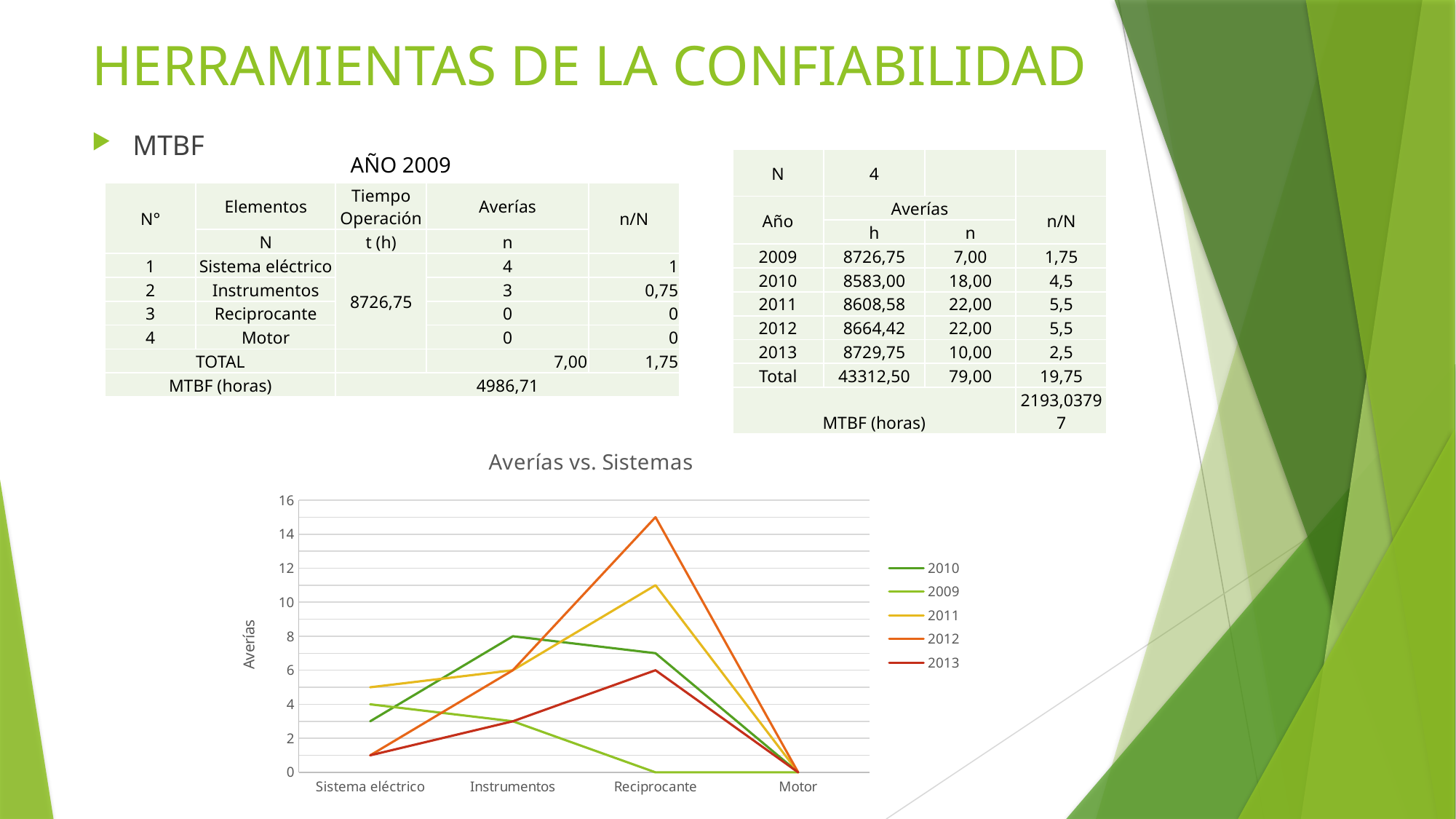
What kind of chart is "Averías vs. Sistemas"? line chart In the "Averías vs. Sistemas" chart, what is the value for Motor in every series? 0 How many series does the legend of the "Averías vs. Sistemas" chart list? 5 In the "Averías vs. Sistemas" chart, which series reaches the highest value at Reciprocante? 2012 In the "Averías vs. Sistemas" chart, what is the 2010 value for Instrumentos? 8 What is the label on the y axis of the "Averías vs. Sistemas" chart? Averías In the "Averías vs. Sistemas" chart, is the 2011 value for Reciprocante greater or less than 10? greater In the "Averías vs. Sistemas" chart, which is larger at Reciprocante: the 2011 value or the 2013 value? 2011 How many categories are shown on the x axis of the "Averías vs. Sistemas" chart? 4 In the "Averías vs. Sistemas" chart, does the 2009 series rise or fall from Sistema eléctrico to Motor? fall In the "Averías vs. Sistemas" chart, is the 2012 value for Reciprocante greater or less than 14? greater In the "Averías vs. Sistemas" chart, what is the 2009 value for Sistema eléctrico? 4